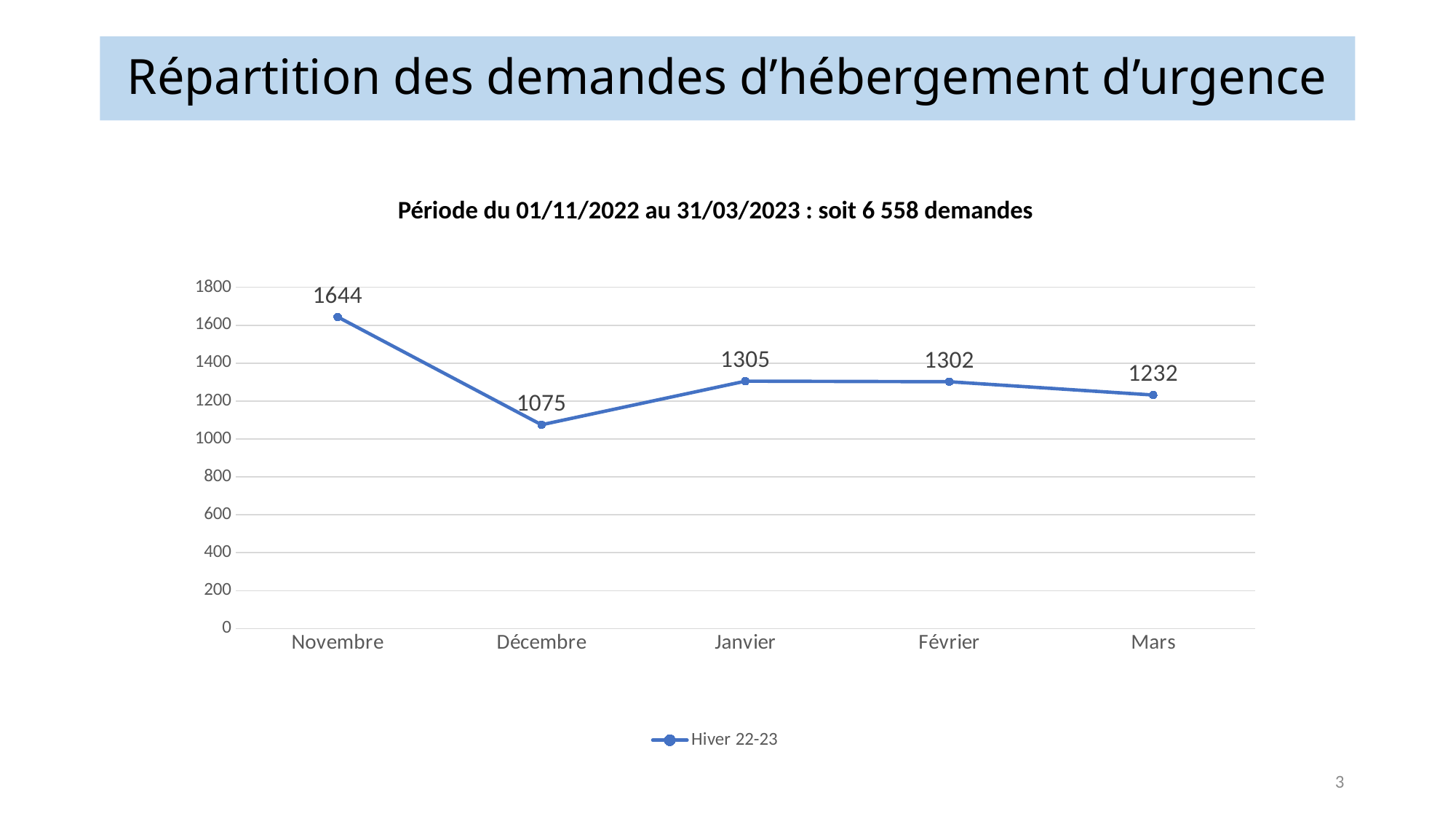
What is the value for Décembre? 1075 Which month has the lowest value? Décembre What is the value for Mars? 1232 How many months are plotted on the x axis? 5 What is the difference between the values for Novembre and Décembre? 569 How many series does the legend list? 1 What is the name of the series in the legend? Hiver 22-23 Which month has the highest value? Novembre Which is larger, the value for Janvier or the value for Mars? Janvier What is the value for Novembre? 1644 What kind of chart is shown? line chart What is the difference between the values for Janvier and Mars? 73